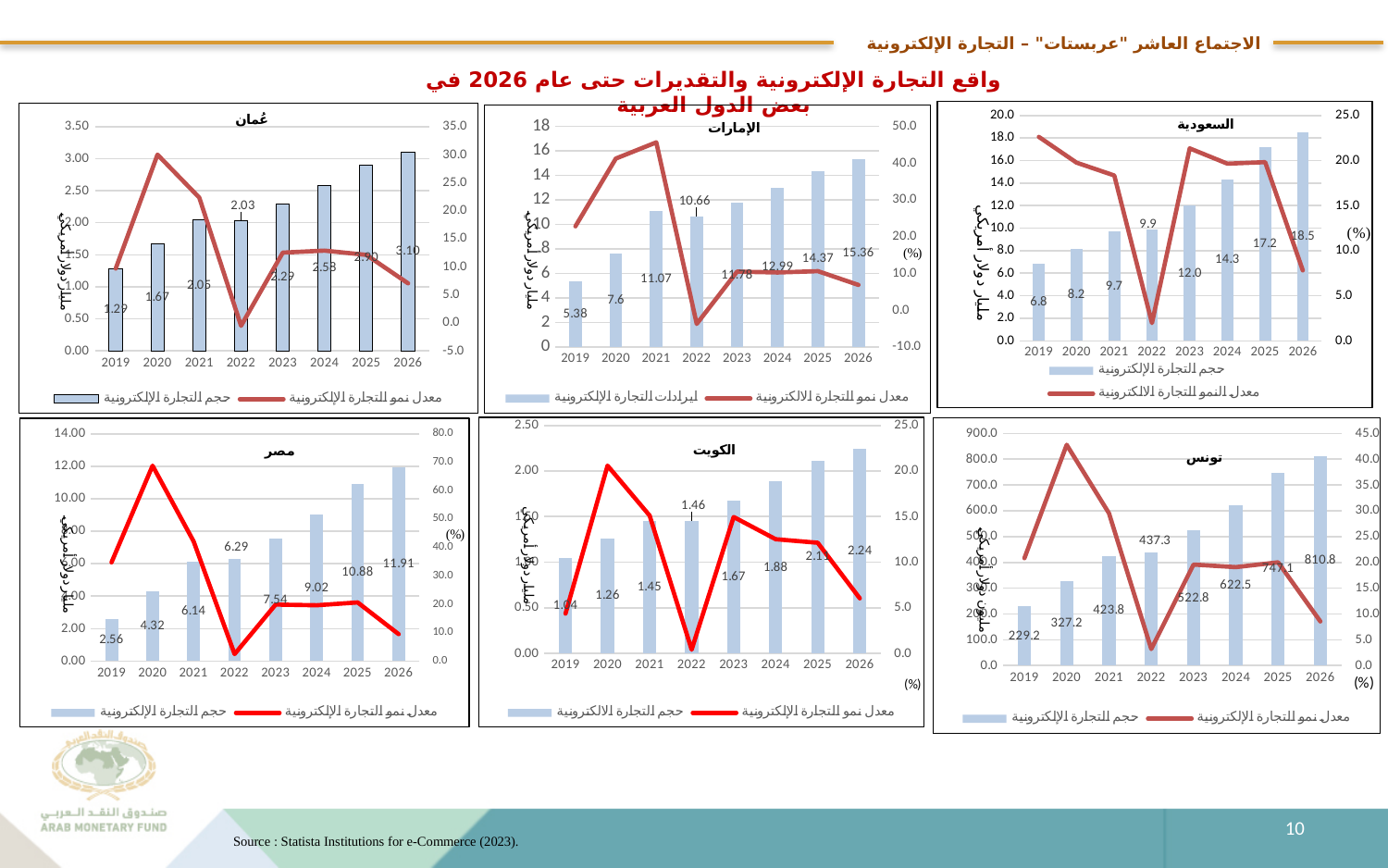
In the السعودية chart, what is the e-commerce volume (bar) value for 2026? 18.5 How many years are shown on the x axis of the السعودية chart? 8 In the الإمارات chart, what is the bar value for 2022? 10.66 In the تونس chart, what is the difference between the bar values for 2026 and 2025? 63.7 How many series does the legend of the الكويت chart list? 2 In the تونس chart, what is the bar value for 2019? 229.2 In the الكويت chart, which year has the lowest bar value? 2019 In the الإمارات chart, which year has the larger bar value, 2021 or 2022? 2021 What kind of chart is the عُمان chart? A combined bar and line chart In the مصر chart, which year has the highest bar value? 2026 In the مصر chart, is the growth-rate line value for 2020 greater or less than 60.0? greater In the عُمان chart, what is the difference between the bar values for 2026 and 2019? 1.81